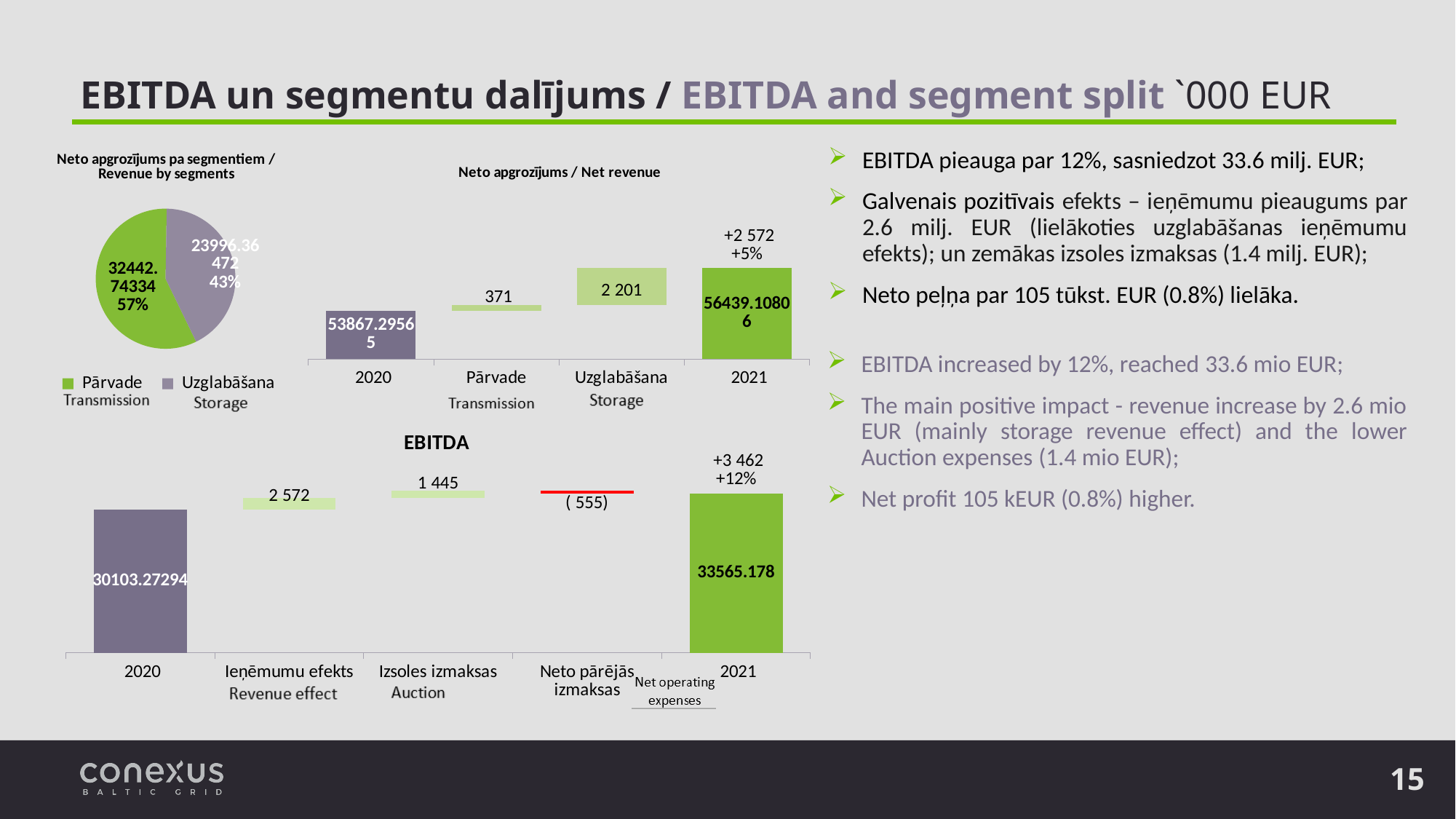
In the EBITDA chart, what is the value shown for Neto pārējās izmaksas / Net operating expenses? ( 555) In the Net revenue chart, what change and percentage are shown above the 2021 bar? +2 572, +5% In the Revenue by segments pie chart, what share does Pārvade / Transmission hold? 57% How many entries does the legend of the Revenue by segments pie chart list? 2 In the EBITDA chart, what is the value shown for 2020? 30103.27294 In the Net revenue chart, what is the value shown for 2020? 53867.29565 In the Revenue by segments pie chart, which segment is larger, Pārvade / Transmission or Uzglabāšana / Storage? Pārvade / Transmission In the Net revenue chart, what is the value shown for 2021? 56439.10806 In the EBITDA chart, how many categories are shown on the x axis? 5 In the Revenue by segments pie chart, what is the value shown for Uzglabāšana / Storage? 23996.36472 In the Net revenue chart, what is the value shown for Uzglabāšana / Storage? 2 201 What kind of chart is the Revenue by segments chart? Pie chart